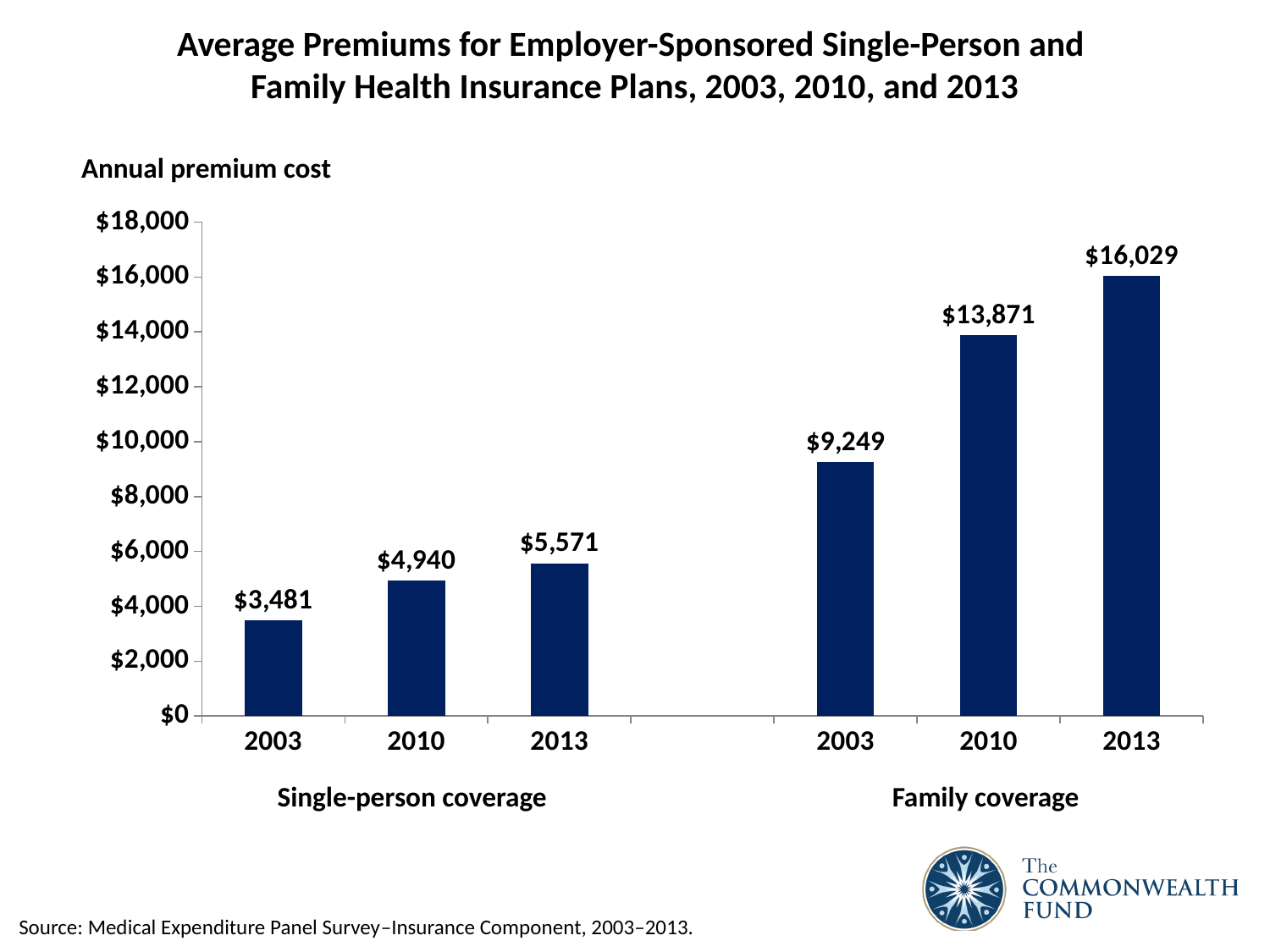
How many bars are plotted on the chart? 6 What was the average annual premium for single-person coverage in 2003? $3,481 Is the family coverage premium in 2010 greater or less than $12,000? greater Which bar shows the highest annual premium cost? Family coverage, 2013 What was the average annual premium for family coverage in 2010? $13,871 What is the difference between the single-person premium in 2013 and in 2010? $631 Which bar shows the lowest annual premium cost? Single-person coverage, 2003 How much higher was the family coverage premium in 2013 than in 2003? $6,780 Which is larger: the single-person premium in 2013 or the family premium in 2003? Family premium in 2003 What was the average annual premium for family coverage in 2013? $16,029 Do the family coverage premiums rise or fall from 2003 to 2013? Rise What kind of chart is shown on the slide? Bar chart